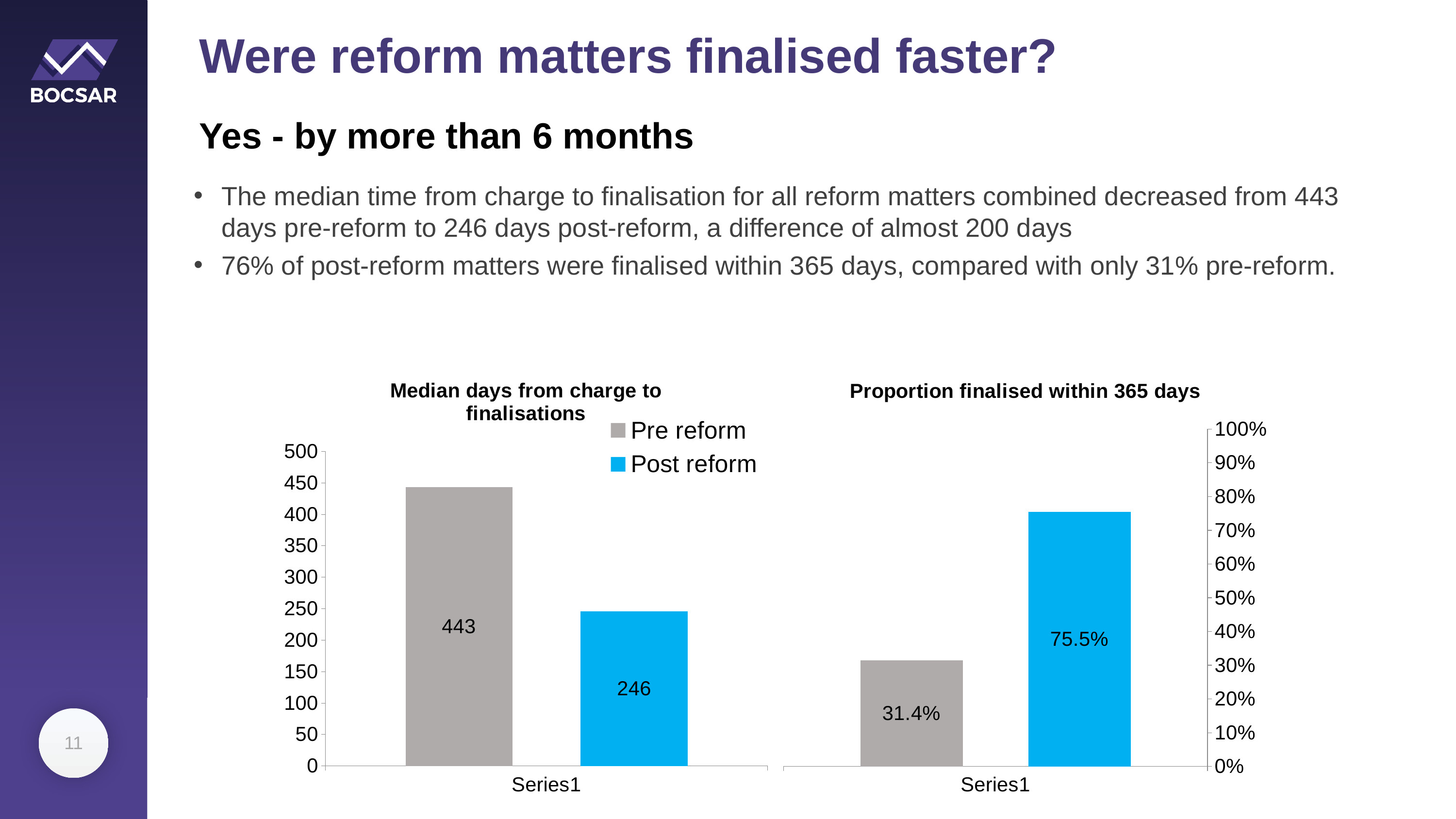
In the 'Proportion finalised within 365 days' chart, what is the value for Pre reform? 31.4% In the 'Median days from charge to finalisations' chart, is the Post reform value greater or less than 300? less What type of chart is the 'Proportion finalised within 365 days' chart? Bar chart In the 'Proportion finalised within 365 days' chart, which series has the lower value? Pre reform In the 'Median days from charge to finalisations' chart, what is the value for Pre reform? 443 In the 'Median days from charge to finalisations' chart, which series has the higher value? Pre reform In the 'Median days from charge to finalisations' chart, what is the value for Post reform? 246 In the 'Proportion finalised within 365 days' chart, is the Post reform value greater or less than 70%? greater In the 'Proportion finalised within 365 days' chart, what is the value for Post reform? 75.5% How many series does the legend list for the charts on the slide? 2 In the 'Proportion finalised within 365 days' chart, what is the difference between the Post reform and Pre reform values? 44.1% In the 'Median days from charge to finalisations' chart, what is the difference between the Pre reform and Post reform values? 197